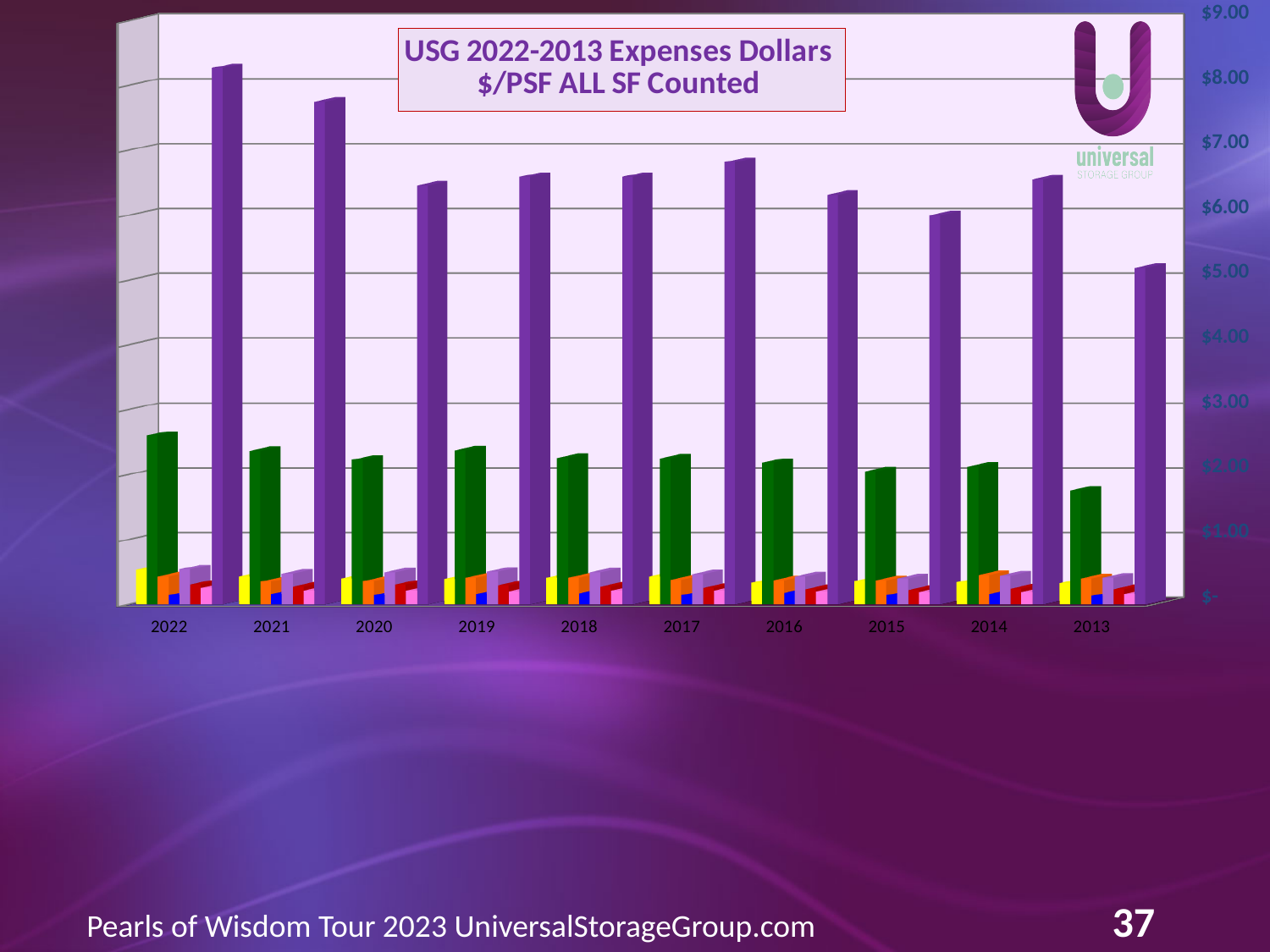
How many years are shown along the x axis of the chart? 10 What is the title of the chart? USG 2022-2013 Expenses Dollars $/PSF ALL SF Counted What is the highest value shown on the chart's vertical axis? $9.00 Which year has the larger tall dark purple bar, 2022 or 2021? 2022 In which year is the green bar the highest? 2022 In which year is the tall dark purple bar the lowest? 2013 What kind of chart is shown on the slide? bar chart In which year is the tall dark purple bar the highest? 2022 Is the green bar for 2013 greater or less than $2.00? less Is the tall dark purple bar for 2021 greater or less than $7.00? greater Is the tall dark purple bar for 2022 greater or less than $8.00? greater In which year is the green bar the lowest? 2013